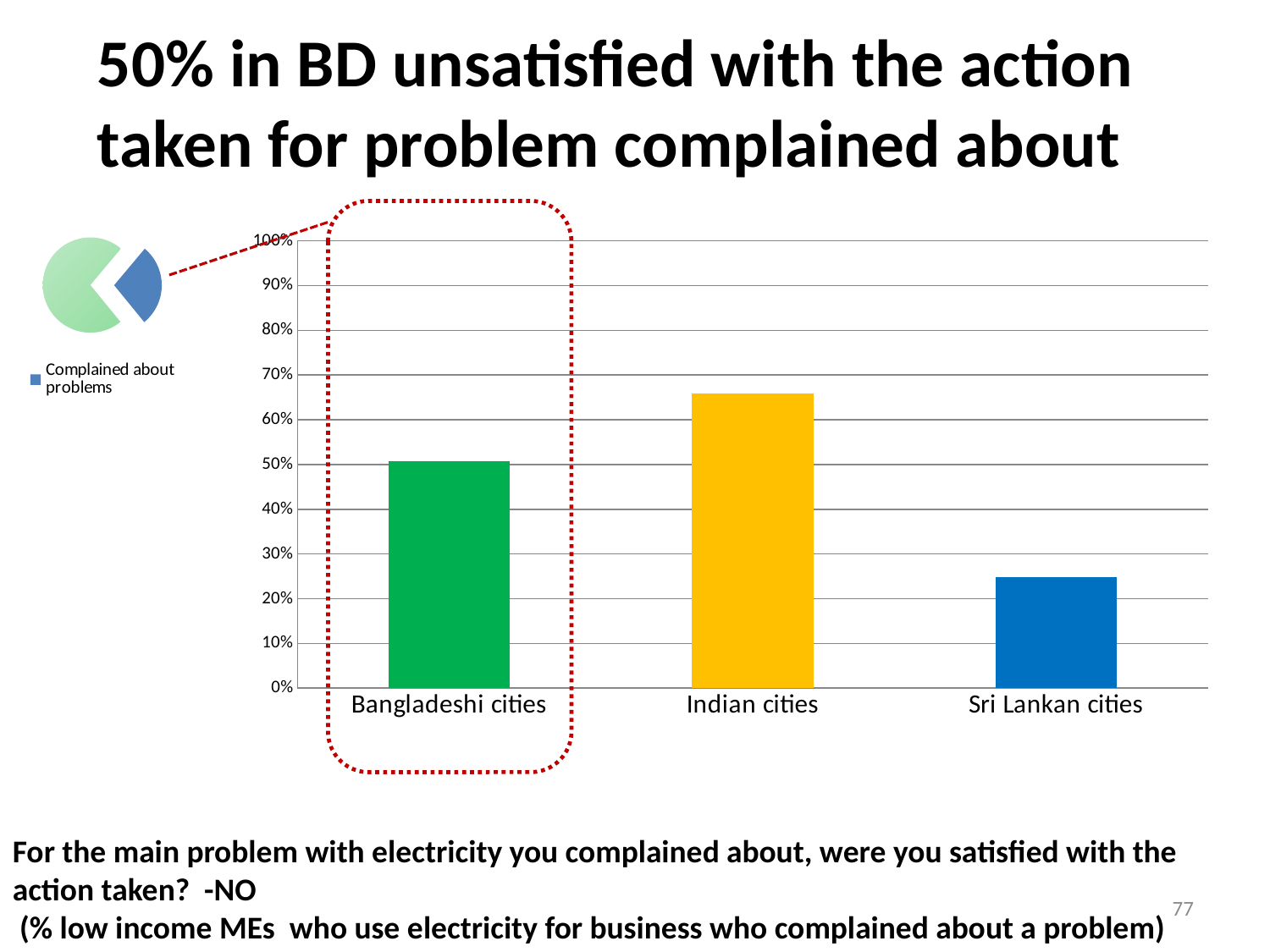
What legend entry is shown next to the small pie chart on the left of the slide? Complained about problems In the bar chart, which is larger, the value for Indian cities or the value for Bangladeshi cities? Indian cities In the bar chart, which category has the highest value? Indian cities In the bar chart, how many categories are shown on the x axis? 3 In the bar chart, is the value for Sri Lankan cities greater or less than 30%? less In the bar chart, is the value for Indian cities greater or less than 70%? less In the bar chart, which category has the lowest value? Sri Lankan cities In the bar chart, what colour is the bar for Indian cities? yellow In the bar chart, is the value for Bangladeshi cities greater or less than 40%? greater What kind of chart is the large chart in the centre of the slide? bar chart In the bar chart, which is larger, the value for Bangladeshi cities or the value for Sri Lankan cities? Bangladeshi cities